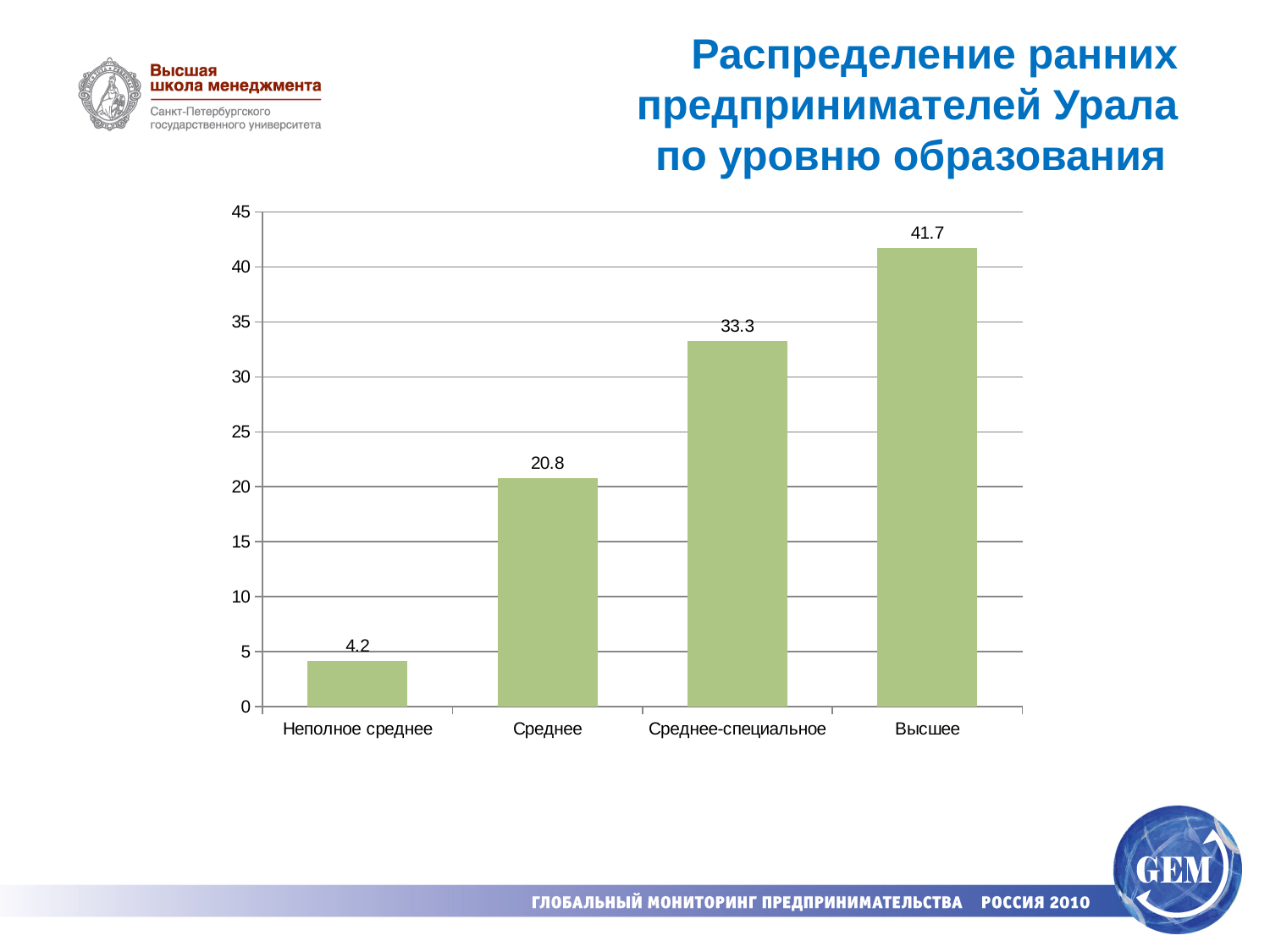
Which category has the lowest value? Неполное среднее What is the value for Высшее? 41.7 What is the value for Среднее? 20.8 How many categories are shown on the x axis? 4 Is the value for Среднее greater or less than 25? less What is the value for Неполное среднее? 4.2 What is the value for Среднее-специальное? 33.3 What kind of chart is shown on the slide? bar chart Which is larger, the value for Среднее or the value for Среднее-специальное? Среднее-специальное What is the difference between the values for Высшее and Среднее-специальное? 8.4 Do the values rise or fall from left to right along the x axis? rise Which category has the highest value? Высшее